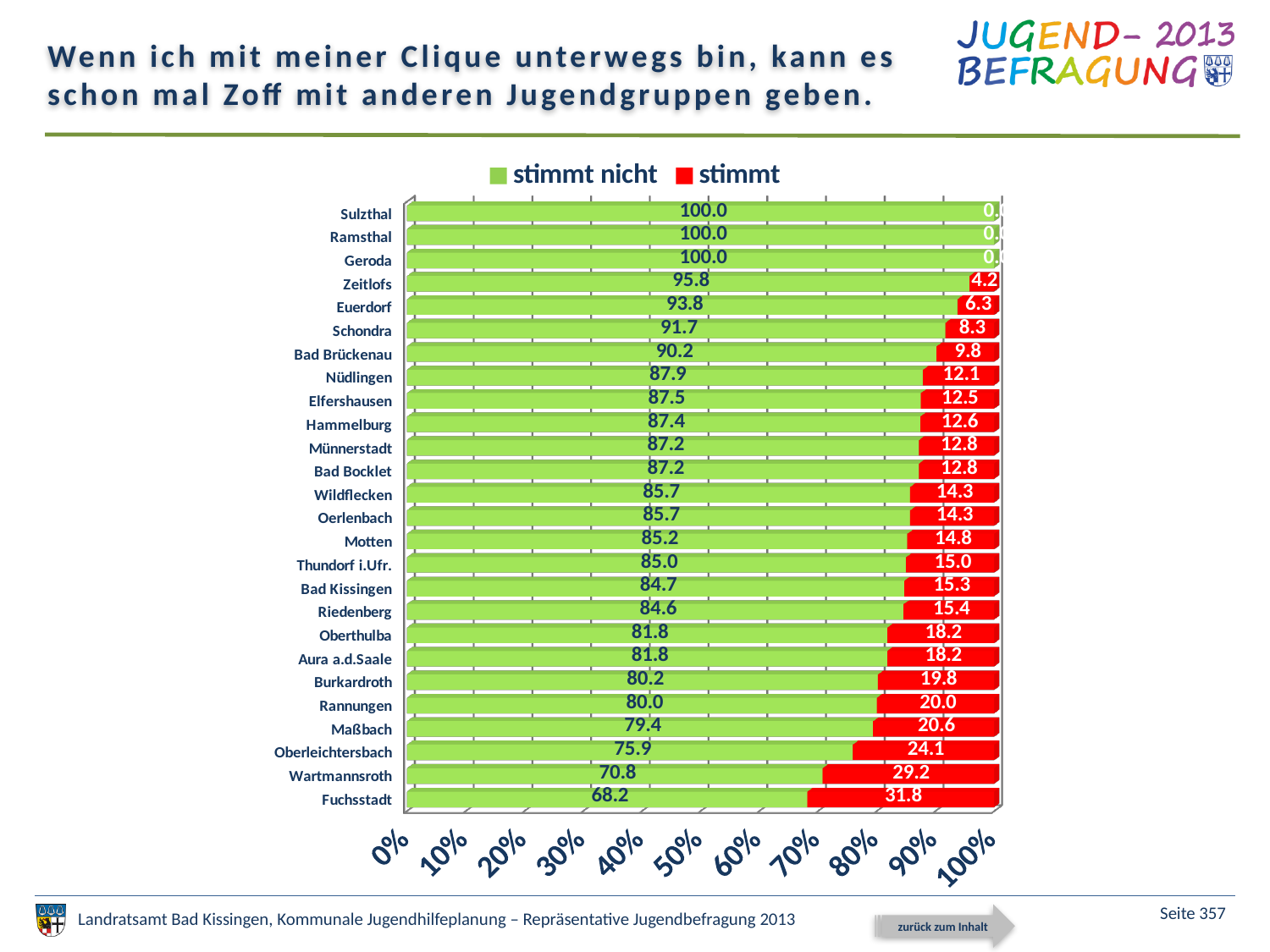
How many categories are shown on the chart? 26 What is the difference between the "stimmt" values for Wartmannsroth and Oberleichtersbach? 5.1 What is the value of "stimmt nicht" for Zeitlofs? 95.8 Which category has the lowest value for "stimmt nicht"? Fuchsstadt What kind of chart is shown on the slide? stacked bar chart What is the value of "stimmt" for Fuchsstadt? 31.8 What is the total of the stacked bar for Fuchsstadt? 100.0 What is the value of "stimmt" for Bad Kissingen? 15.3 Is the "stimmt nicht" value for Wartmannsroth greater or less than 80%? less Which has the larger "stimmt" value, Maßbach or Rannungen? Maßbach Which category has the highest value for "stimmt"? Fuchsstadt How many series does the legend list? 2